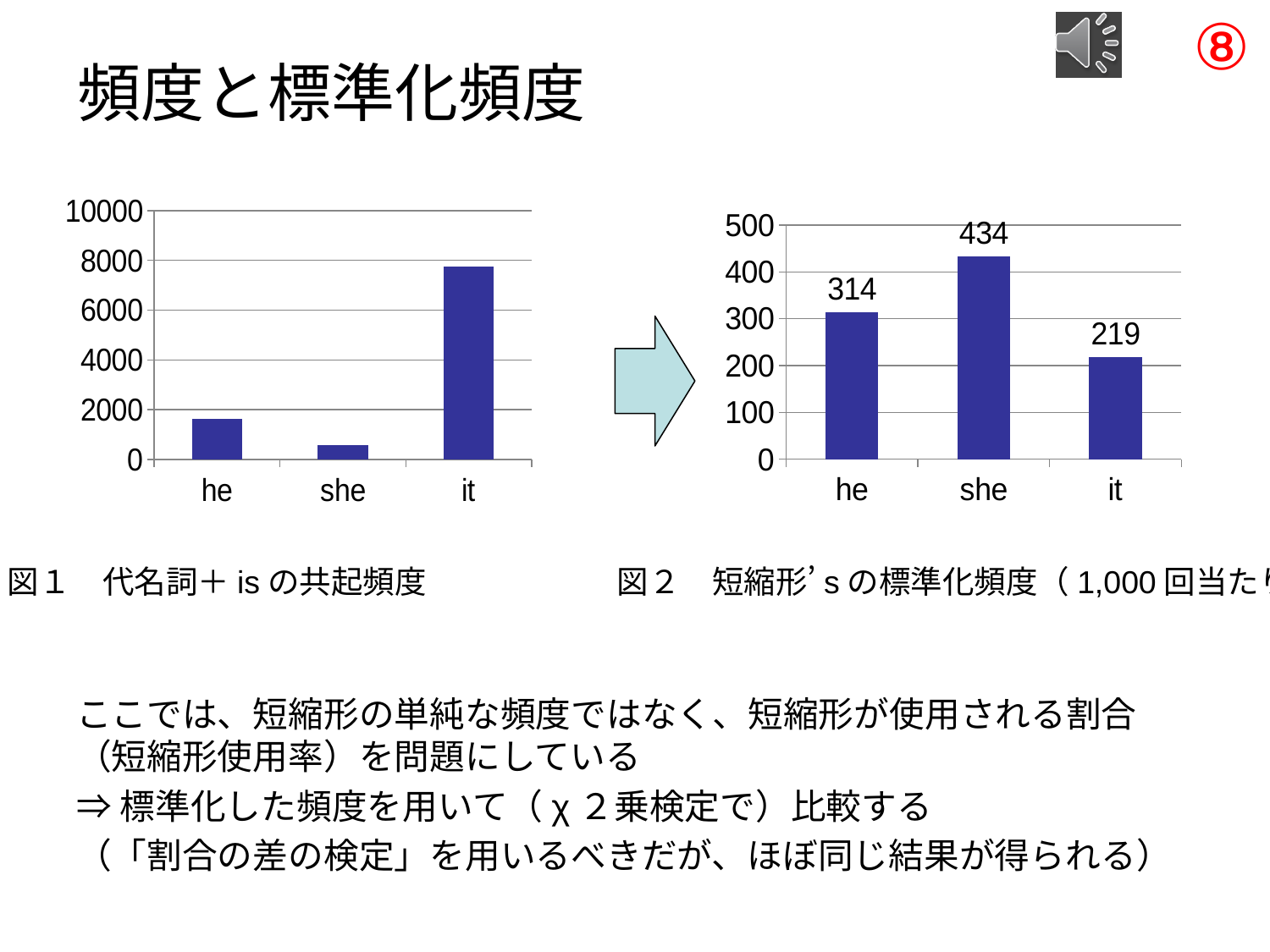
In the right chart (図2), what is the value for it? 219 In the right chart (図2), what is the value for she? 434 In the left chart (図1), which category has the highest value? it In the left chart (図1), is the value for it greater or less than 6000? greater In the right chart (図2), which category has the lowest value? it In the right chart (図2), what is the difference between the values for he and it? 95 In the left chart (図1), is the value for he greater or less than 2000? less In the left chart (図1), which category has the lowest value? she In the right chart (図2), what is the difference between the values for she and he? 120 How many categories are shown on the x axis of the left chart (図1)? 3 In the right chart (図2), what is the value for he? 314 In the right chart (図2), which category has the highest value? she